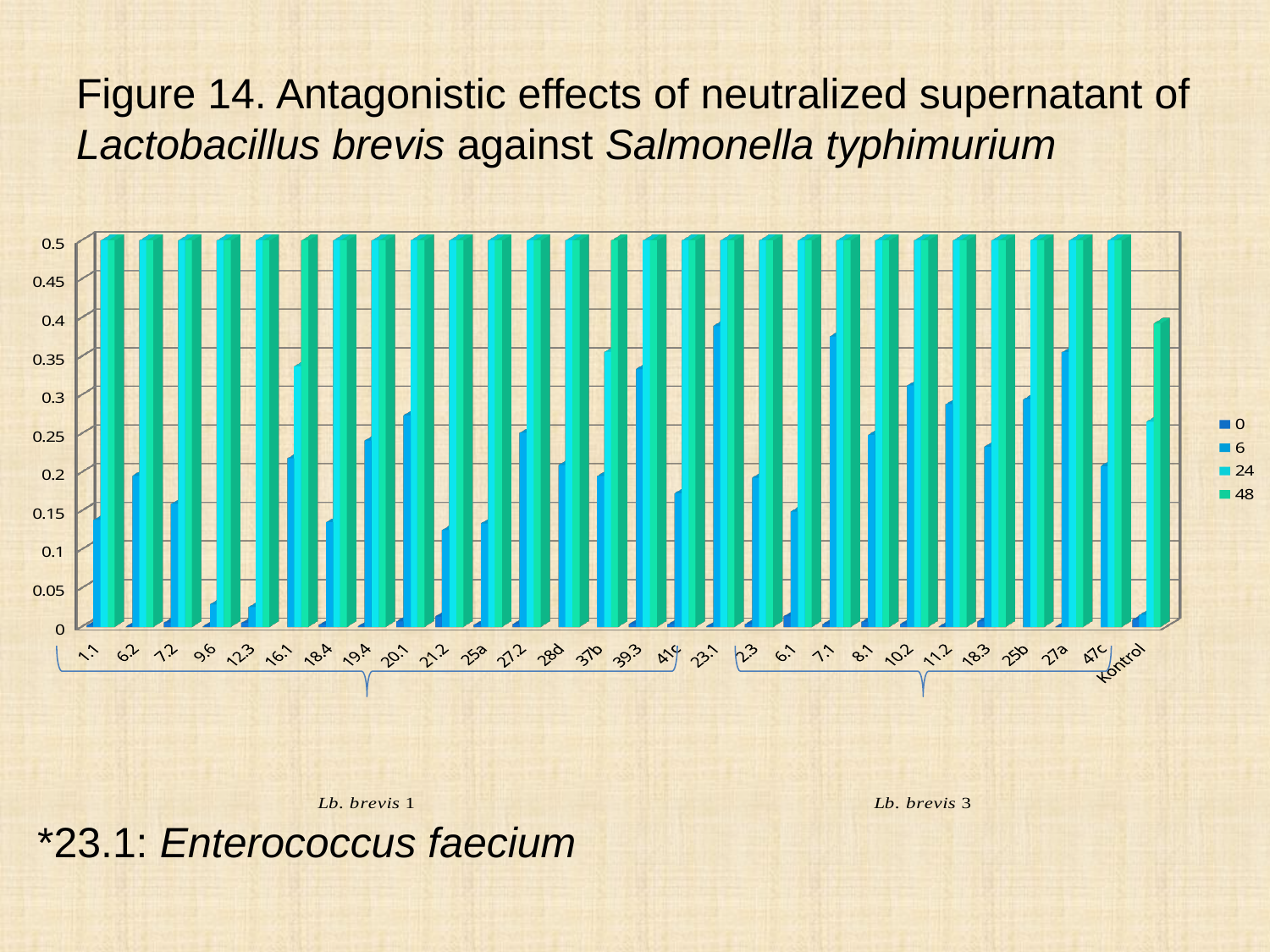
What is the label of the last category on the x axis? Kontrol What are the series names listed in the legend? 0, 6, 24, 48 For series 6, which is larger: the value for category 7.1 or the value for category 6.1? 7.1 How many series does the legend list? 4 Is the value of series 48 for category Kontrol greater or less than 0.5? less Is the value of series 24 for category Kontrol greater or less than 0.2? greater How many categories are shown along the x axis? 28 What kind of chart is shown on the slide? Bar chart For series 6, which is larger: the value for category 23.1 or the value for category 9.6? 23.1 Is the value of series 6 for category 23.1 greater or less than 0.3? greater